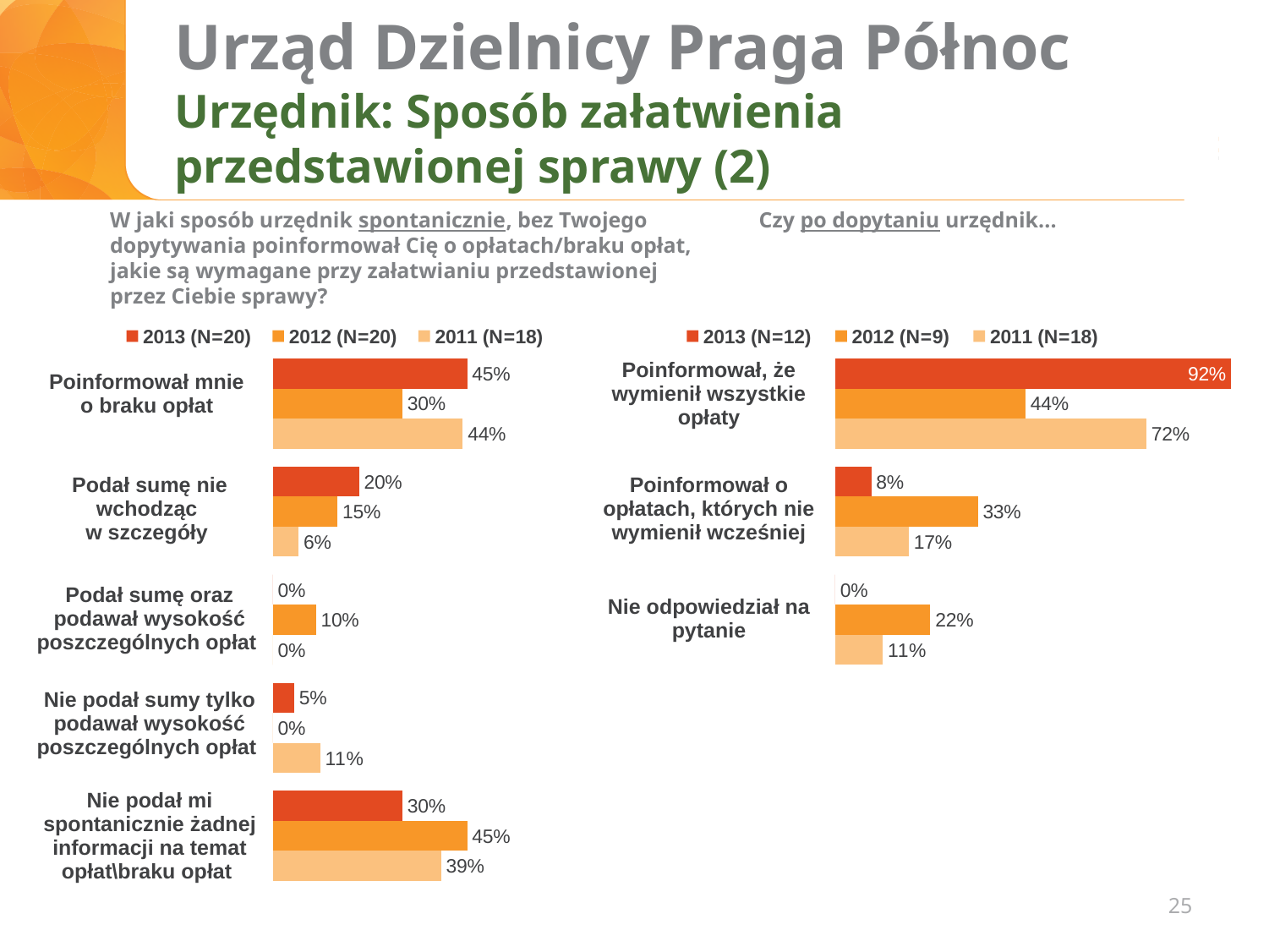
In the right chart, what is the 2012 (N=9) value for 'Nie odpowiedział na pytanie'? 22% In the right chart, what is the difference between the 2013 (N=12) and 2011 (N=18) values for 'Poinformował, że wymienił wszystkie opłaty'? 20 percentage points In the left chart, what sample size is given for the 2011 series in the legend? N=18 How many series does the legend of the right chart list? 3 How many categories does the left chart show? 5 What kind of chart is the right chart? Bar chart In the left chart, which category has the lowest 2012 (N=20) value? Nie podał sumy tylko podawał wysokość poszczególnych opłat In the right chart, what is the 2012 (N=9) value for 'Poinformował o opłatach, których nie wymienił wcześniej'? 33% In the left chart, what is the 2011 (N=18) value for 'Nie podał mi spontanicznie żadnej informacji na temat opłat\braku opłat'? 39% In the right chart, which category has the highest 2013 (N=12) value? Poinformował, że wymienił wszystkie opłaty In the left chart, which is larger for 'Podał sumę nie wchodząc w szczegóły': the 2013 (N=20) value or the 2011 (N=18) value? 2013 (N=20) In the left chart, what is the 2013 (N=20) value for 'Poinformował mnie o braku opłat'? 45%